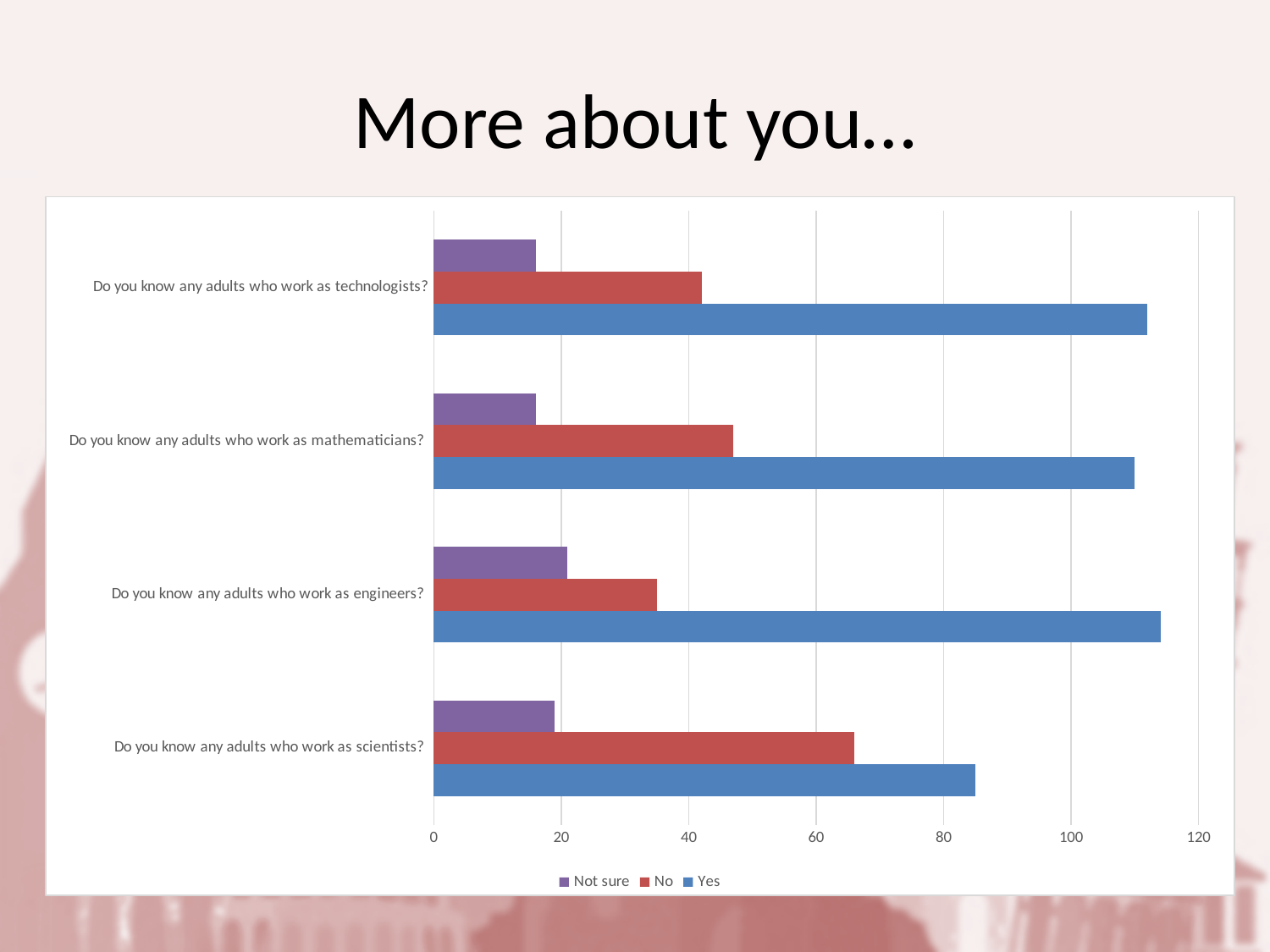
Which question has the lowest 'No' value? Do you know any adults who work as engineers? Which series is shown in blue in the legend? Yes How many series does the legend list? 3 Which question has the lowest 'Yes' value? Do you know any adults who work as scientists? What kind of chart is shown on the slide? bar chart How many questions (categories) are plotted on the chart? 4 Which question has the highest 'No' value? Do you know any adults who work as scientists? Is the 'No' value for 'Do you know any adults who work as engineers?' greater or less than 40? less Is the 'Yes' value for 'Do you know any adults who work as scientists?' greater or less than 80? greater Which is larger: the 'No' value for scientists or the 'No' value for mathematicians? scientists Is the 'Yes' value for 'Do you know any adults who work as technologists?' greater or less than 100? greater